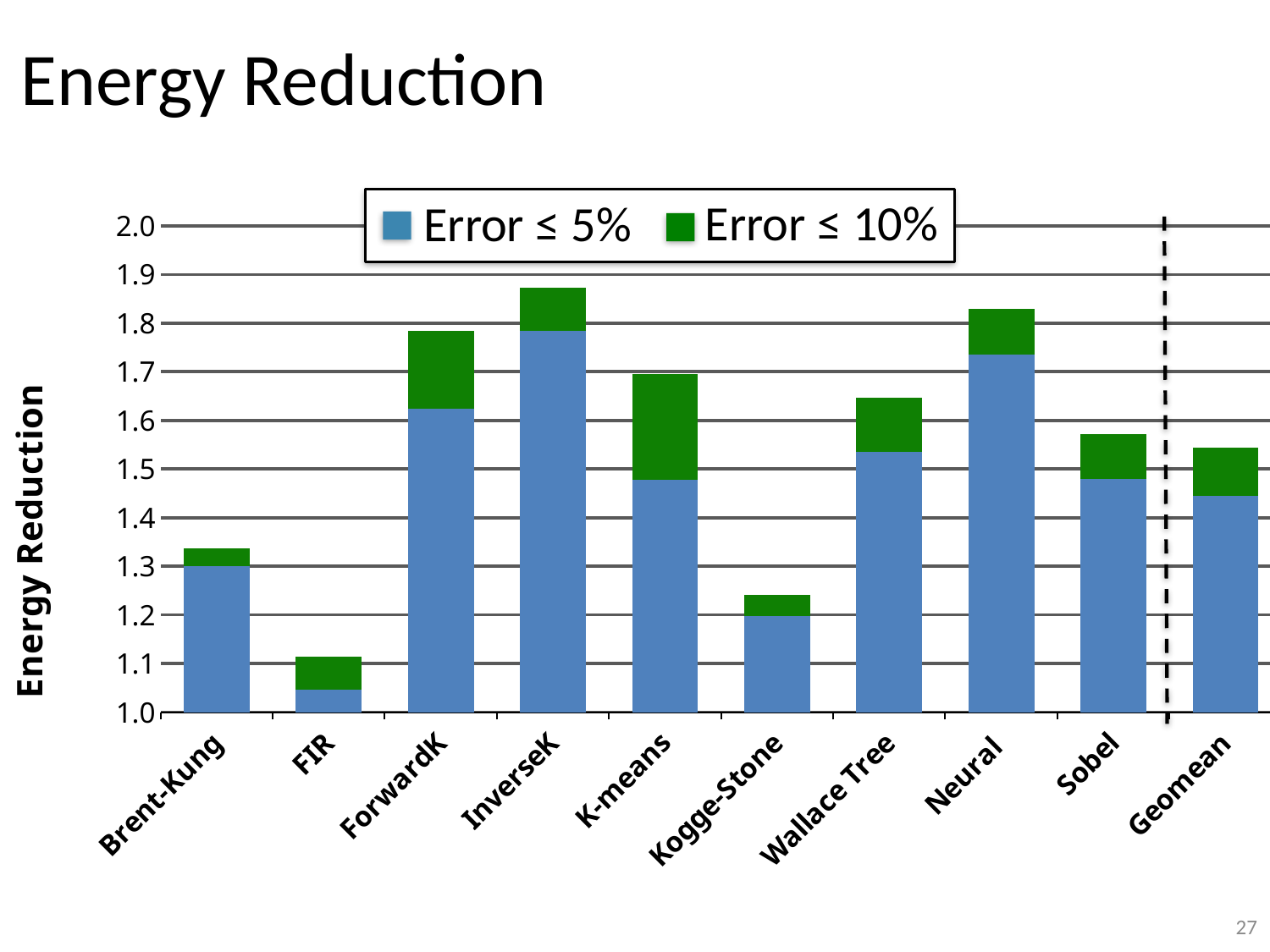
Which has the larger Error ≤ 5% value, ForwardK or Neural? Neural What kind of chart is shown on the slide? bar chart Is the Error ≤ 5% value for Brent-Kung greater or less than 1.4? less Is the Error ≤ 5% value for InverseK greater or less than 1.7? greater Which category has the lowest overall bar? FIR Which has the larger overall bar, K-means or Wallace Tree? K-means How many series does the legend list? 2 Which category has the highest overall bar? InverseK Is the top of the Neural bar (Error ≤ 10%) greater or less than 1.8? greater What is the label on the y axis? Energy Reduction How many categories are shown along the x axis? 10